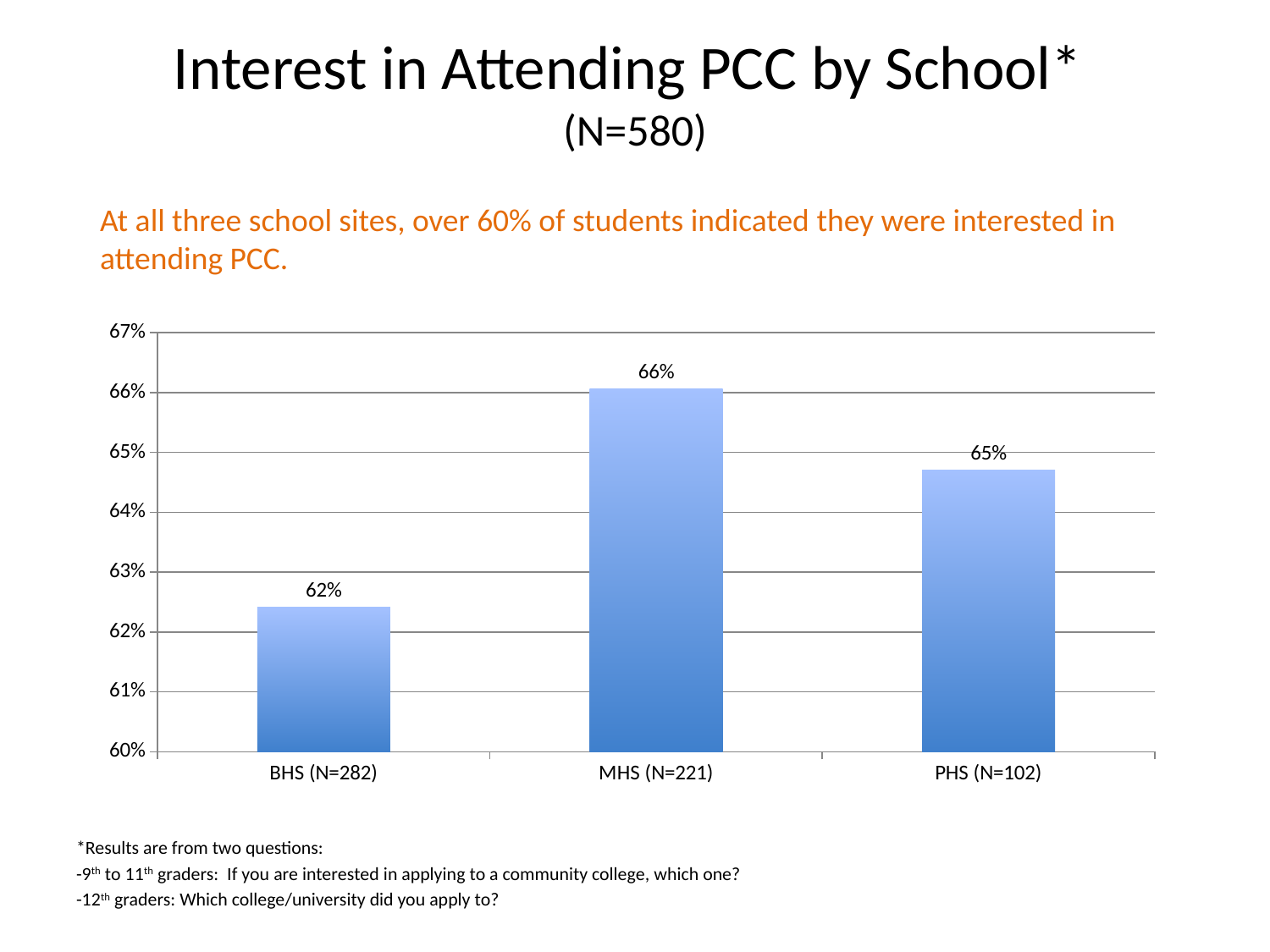
How many schools are shown on the chart? 3 Which school has the lowest percentage of students interested in attending PCC? BHS (N=282) Which is larger, the value for PHS (N=102) or the value for BHS (N=282)? PHS (N=102) What is the value for BHS (N=282)? 62% What is the title of the slide? Interest in Attending PCC by School* (N=580) What kind of chart is shown on the slide? bar chart Which school has the highest percentage of students interested in attending PCC? MHS (N=221) What is the difference between the values for MHS (N=221) and BHS (N=282)? 4% Is the value for MHS (N=221) greater or less than 64%? greater What is the value for PHS (N=102)? 65% Is the value for BHS (N=282) greater or less than 63%? less What is the value for MHS (N=221)? 66%